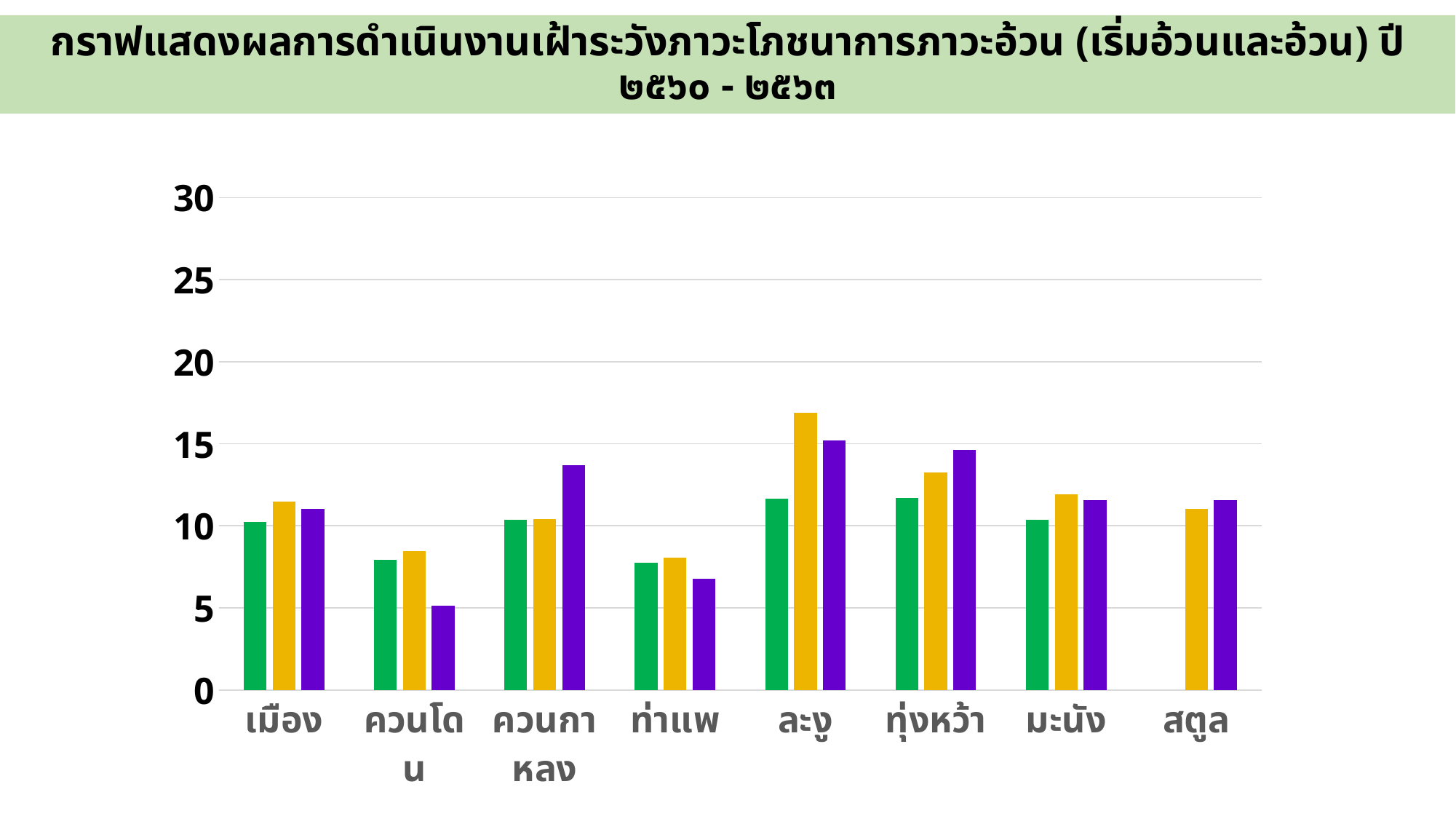
Is the yellow bar for ทุ่งหว้า greater or less than 10? greater Is the green bar for ท่าแพ greater or less than 10? less For ควนกาหลง, which is larger: the green bar or the purple bar? purple bar What kind of chart is shown on the slide? bar chart What is the highest value shown on the y axis? 30 How many categories are shown along the x axis? 8 How many differently coloured bar series are plotted in the chart? 3 Which category has the shortest bar in the chart? ควนโดน Which category is missing a green bar? สตูล Is the yellow bar for ละงู greater or less than 15? greater Which category has the tallest bar in the chart? ละงู